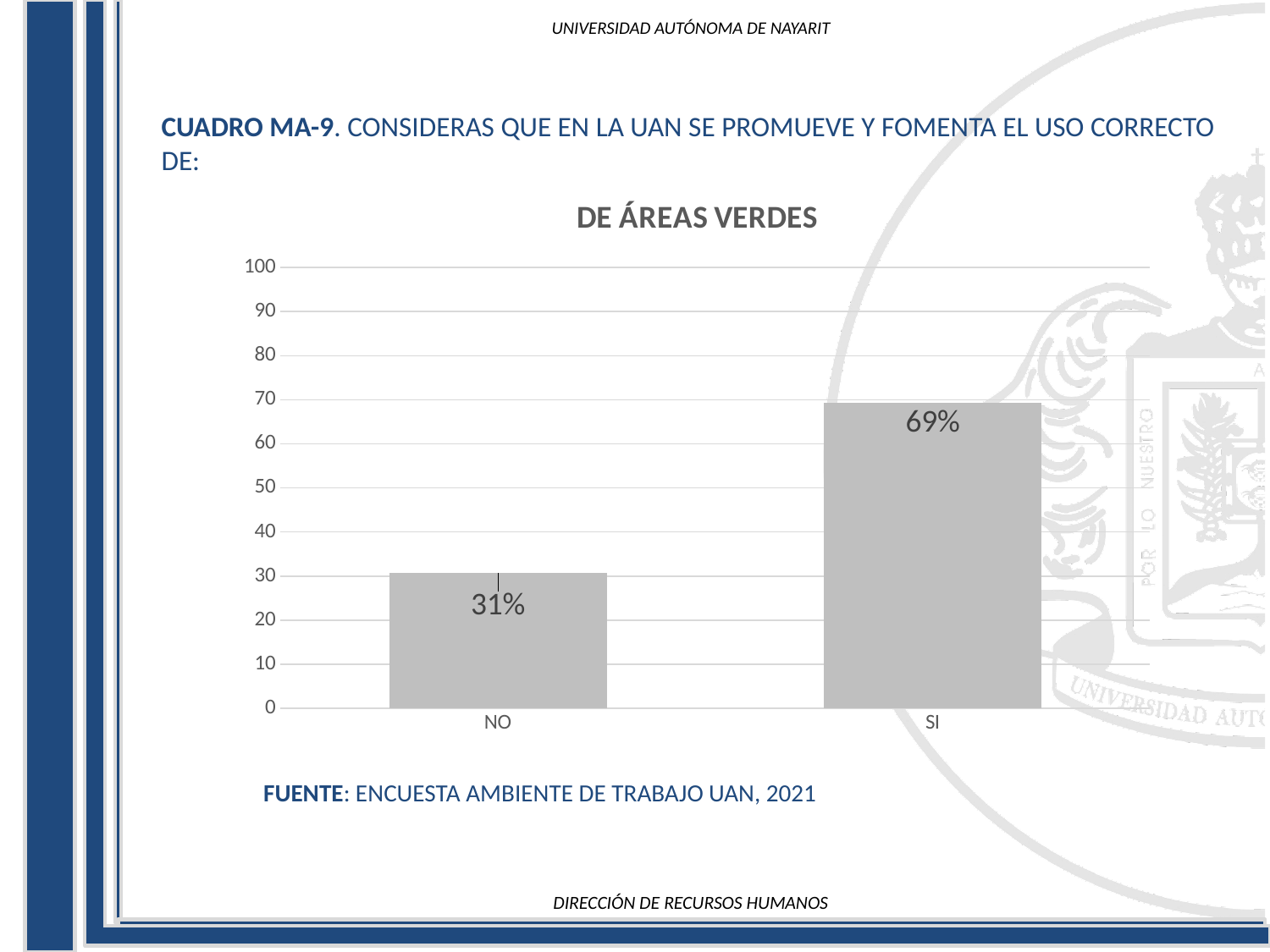
Which is larger, the value for NO or the value for SI? SI What kind of chart is shown on the slide? bar chart What is the value for NO? 31% Which category has the lowest value? NO What is the title of the chart? DE ÁREAS VERDES What is the highest value shown on the y axis? 100 Is the value for NO greater or less than 40? less What is the value for SI? 69% What is the difference between the values for SI and NO? 38% How many categories are shown on the x axis? 2 Which category has the highest value? SI Is the value for SI greater or less than 60? greater